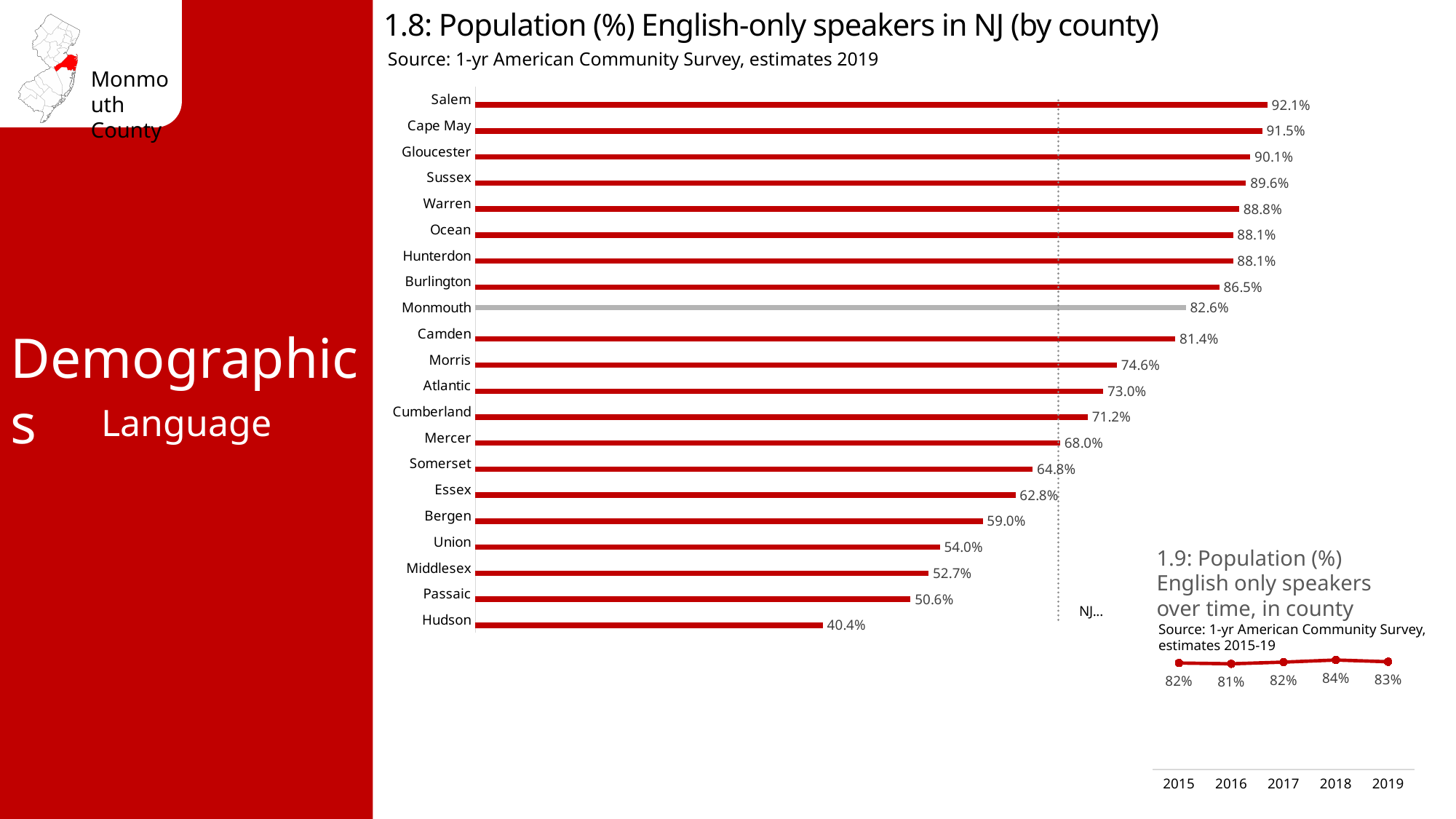
In chart 1.8, which county's bar is shown in grey rather than red? Monmouth What kind of chart is chart 1.8? Bar chart In chart 1.8, which county has the lowest share of English-only speakers? Hudson In chart 1.8, what is the value shown for Hudson? 40.4% In chart 1.8, what is the difference between Salem's value and Hudson's value? 51.7% In chart 1.9, what is the value shown for 2018? 84% In chart 1.8, how many counties are plotted? 21 In chart 1.8, what percentage of Monmouth County's population are English-only speakers? 82.6% In chart 1.9, which year has the lowest value? 2016 In chart 1.8, which county has the highest share of English-only speakers? Salem In chart 1.8, which is larger, the value for Bergen or the value for Union? Bergen In chart 1.9, how many years are plotted? 5